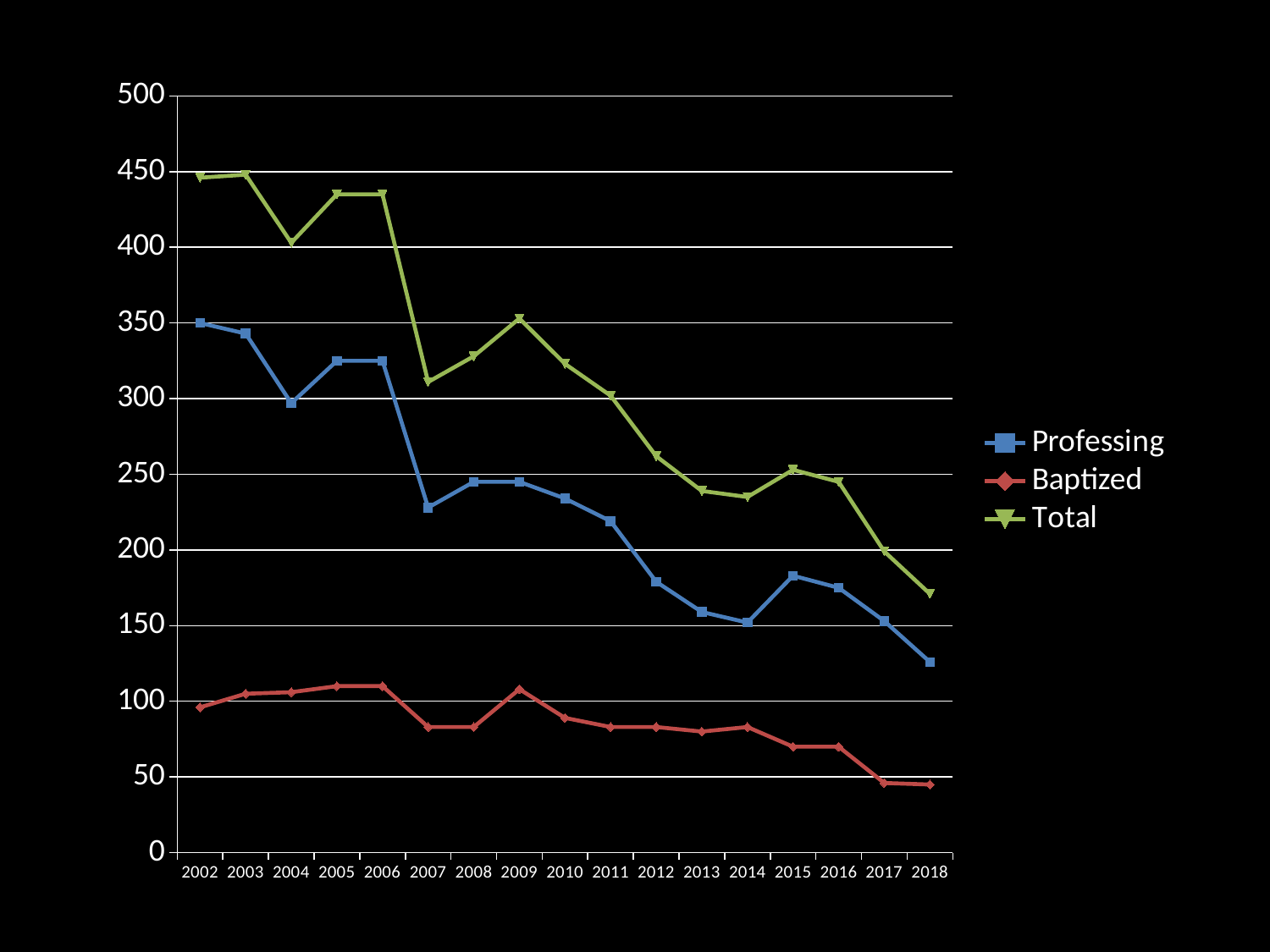
How many series does the legend list? 3 Is the value for Total in 2002 greater or less than 400? greater What colour is the line for the Total series? green Is the value for Baptized in 2005 greater or less than 100? greater Is the value for Professing in 2007 greater or less than 250? less Which is larger, the Professing value in 2014 or in 2015? 2015 How many years are plotted along the x axis? 17 Does the Total series rise or fall overall from 2002 to 2018? fall What kind of chart is shown on the slide? line chart In which year is the Total series at its lowest? 2018